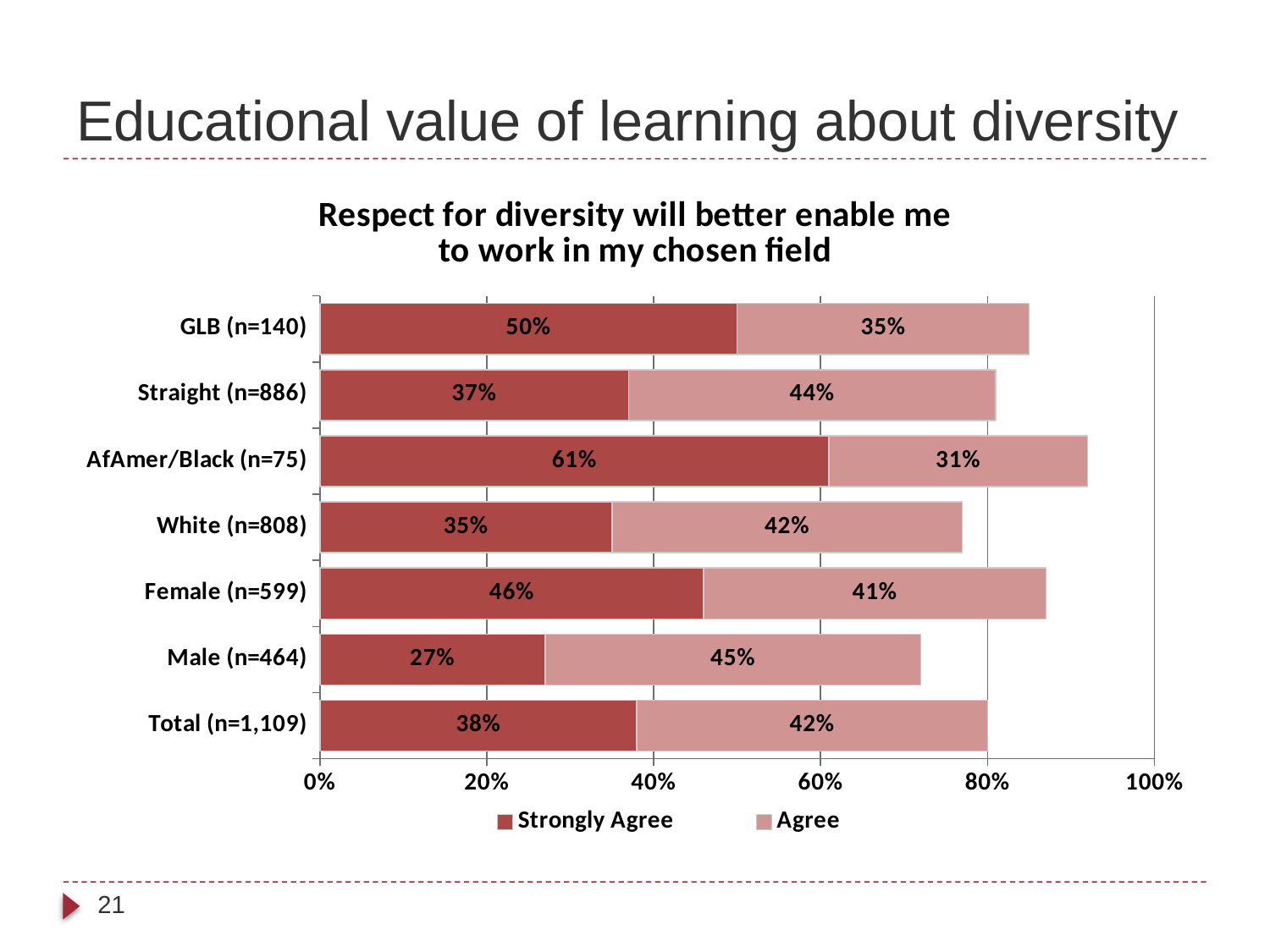
What is the combined Strongly Agree and Agree total for AfAmer/Black (n=75)? 92% What type of chart is shown? Stacked bar chart Which is larger: the Agree value for Straight (n=886) or the Agree value for GLB (n=140)? Straight (n=886) How many categories are shown on the chart? 7 How many series does the legend list? 2 What percentage of Male (n=464) respondents Agree? 45% What percentage of GLB (n=140) respondents Strongly Agree? 50% Which category has the highest Strongly Agree percentage? AfAmer/Black (n=75) What is the combined Strongly Agree and Agree total for White (n=808)? 77% What is the difference between the Strongly Agree percentages for Female (n=599) and Male (n=464)? 19% What is the Strongly Agree value for Total (n=1,109)? 38% Which category has the lowest Strongly Agree percentage? Male (n=464)